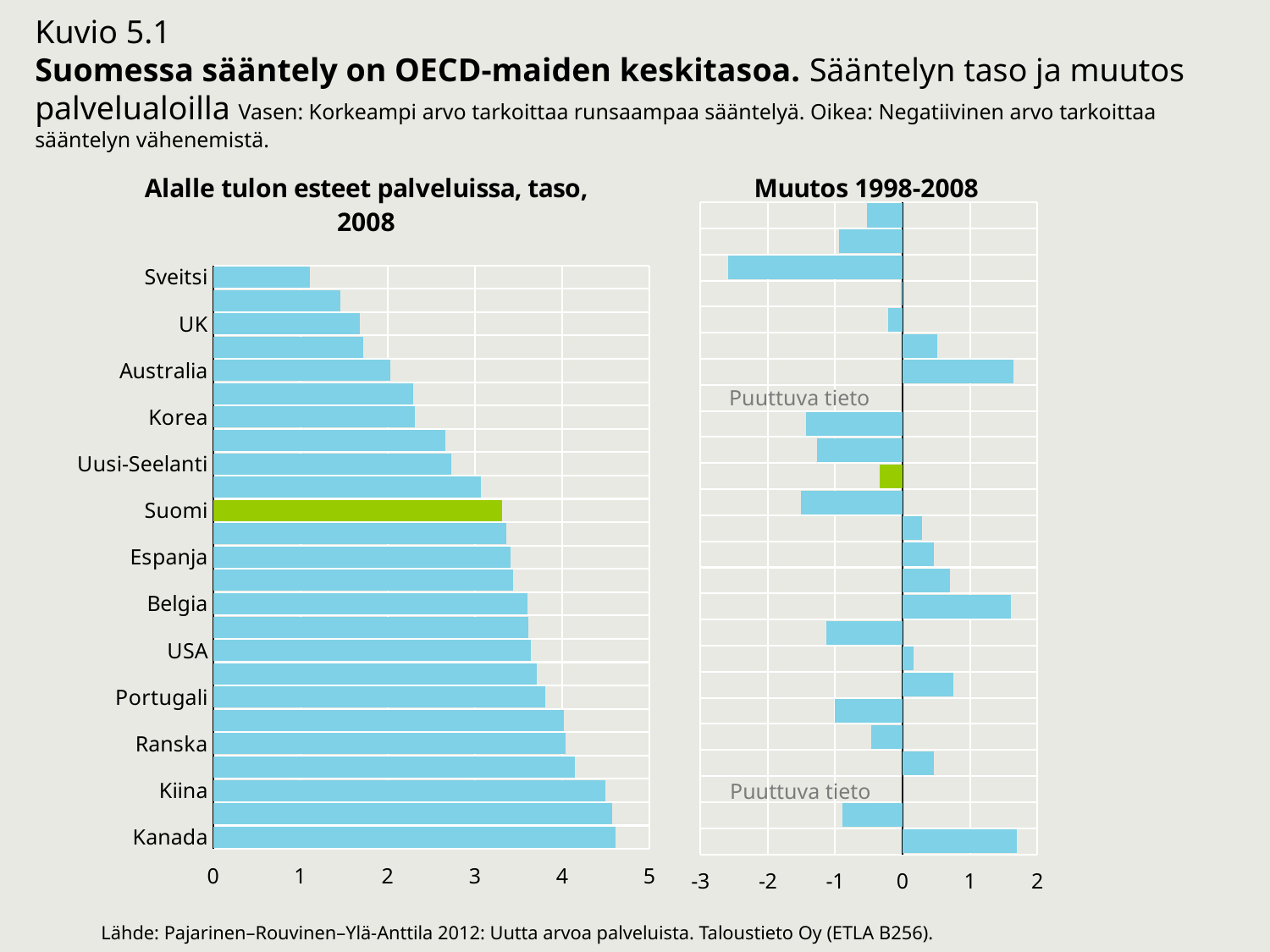
In the right chart 'Muutos 1998-2008', how many rows are marked 'Puuttuva tieto'? 2 In the left chart 'Alalle tulon esteet palveluissa, taso, 2008', is the value for Kanada greater or less than 4? greater In the left chart 'Alalle tulon esteet palveluissa, taso, 2008', is the value for Portugali greater or less than 4? less In the left chart 'Alalle tulon esteet palveluissa, taso, 2008', which has the larger value, Kiina or Korea? Kiina In the left chart 'Alalle tulon esteet palveluissa, taso, 2008', is the value for Suomi greater or less than 3? greater In the left chart 'Alalle tulon esteet palveluissa, taso, 2008', what colour is the bar for Suomi? green In the left chart 'Alalle tulon esteet palveluissa, taso, 2008', which has the larger value, Suomi or UK? Suomi In the left chart 'Alalle tulon esteet palveluissa, taso, 2008', which labelled country has the lowest value? Sveitsi What kind of chart is the left chart titled 'Alalle tulon esteet palveluissa, taso, 2008'? bar chart In the left chart 'Alalle tulon esteet palveluissa, taso, 2008', which labelled country has the highest value? Kanada